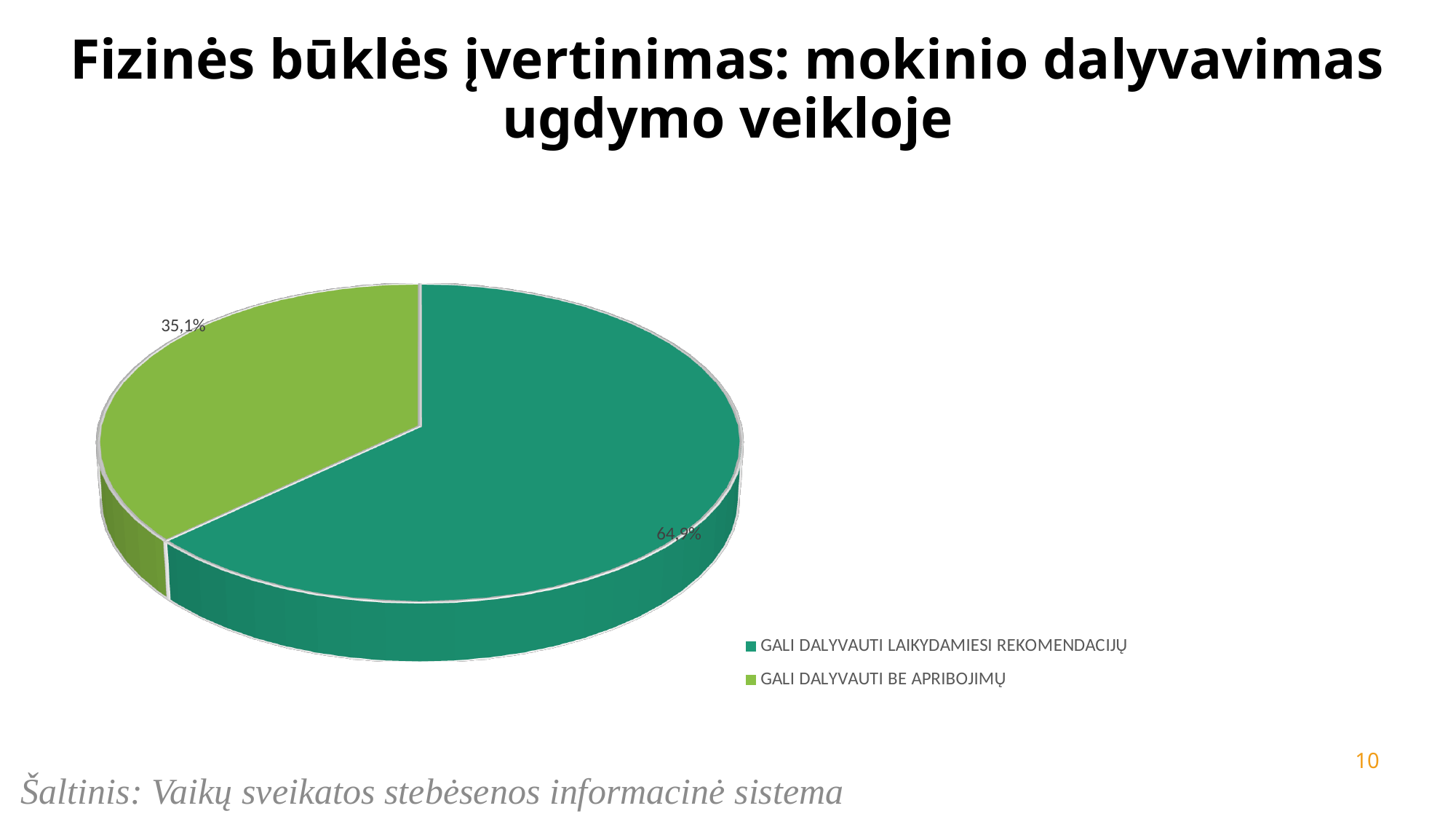
How many slices does the pie chart have? 2 Which category has the largest slice of the pie? GALI DALYVAUTI LAIKYDAMIESI REKOMENDACIJŲ Is the share for GALI DALYVAUTI LAIKYDAMIESI REKOMENDACIJŲ greater or less than 50%? greater How many entries does the legend list? 2 What kind of chart is shown on the slide? Pie chart What share of the pie does GALI DALYVAUTI LAIKYDAMIESI REKOMENDACIJŲ have? 64,9% What colour is the slice for GALI DALYVAUTI BE APRIBOJIMŲ? Light green What is the difference in percentage points between the GALI DALYVAUTI LAIKYDAMIESI REKOMENDACIJŲ slice and the GALI DALYVAUTI BE APRIBOJIMŲ slice? 29,8 Which is larger: the slice for GALI DALYVAUTI BE APRIBOJIMŲ or the slice for GALI DALYVAUTI LAIKYDAMIESI REKOMENDACIJŲ? GALI DALYVAUTI LAIKYDAMIESI REKOMENDACIJŲ What share of the pie does GALI DALYVAUTI BE APRIBOJIMŲ have? 35,1% What is the title of the slide containing the pie chart? Fizinės būklės įvertinimas: mokinio dalyvavimas ugdymo veikloje Which category has the smallest slice of the pie? GALI DALYVAUTI BE APRIBOJIMŲ